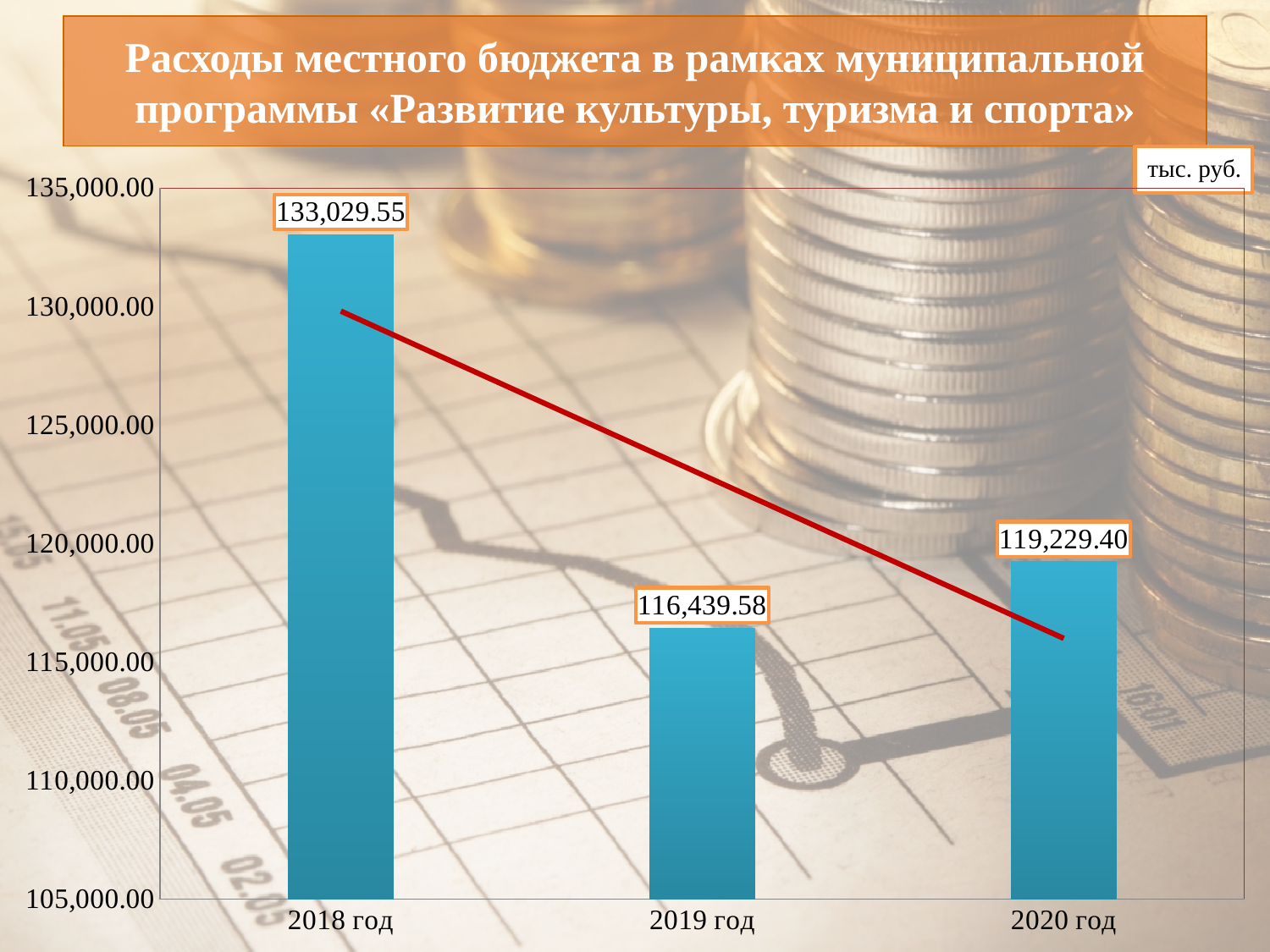
Which year has the highest value? 2018 год How many years are shown on the chart? 3 What is the value for 2019 год? 116,439.58 What kind of chart is shown on the slide? bar chart What is the difference between the values for 2018 год and 2019 год? 16,589.97 Which year has the lowest value? 2019 год Which is larger, the value for 2019 год or the value for 2020 год? 2020 год What is the difference between the values for 2020 год and 2019 год? 2,789.82 What is the value for 2020 год? 119,229.40 Is the value for 2018 год greater or less than 130,000.00? greater In what units are the values on the chart expressed? тыс. руб. What is the value for 2018 год? 133,029.55